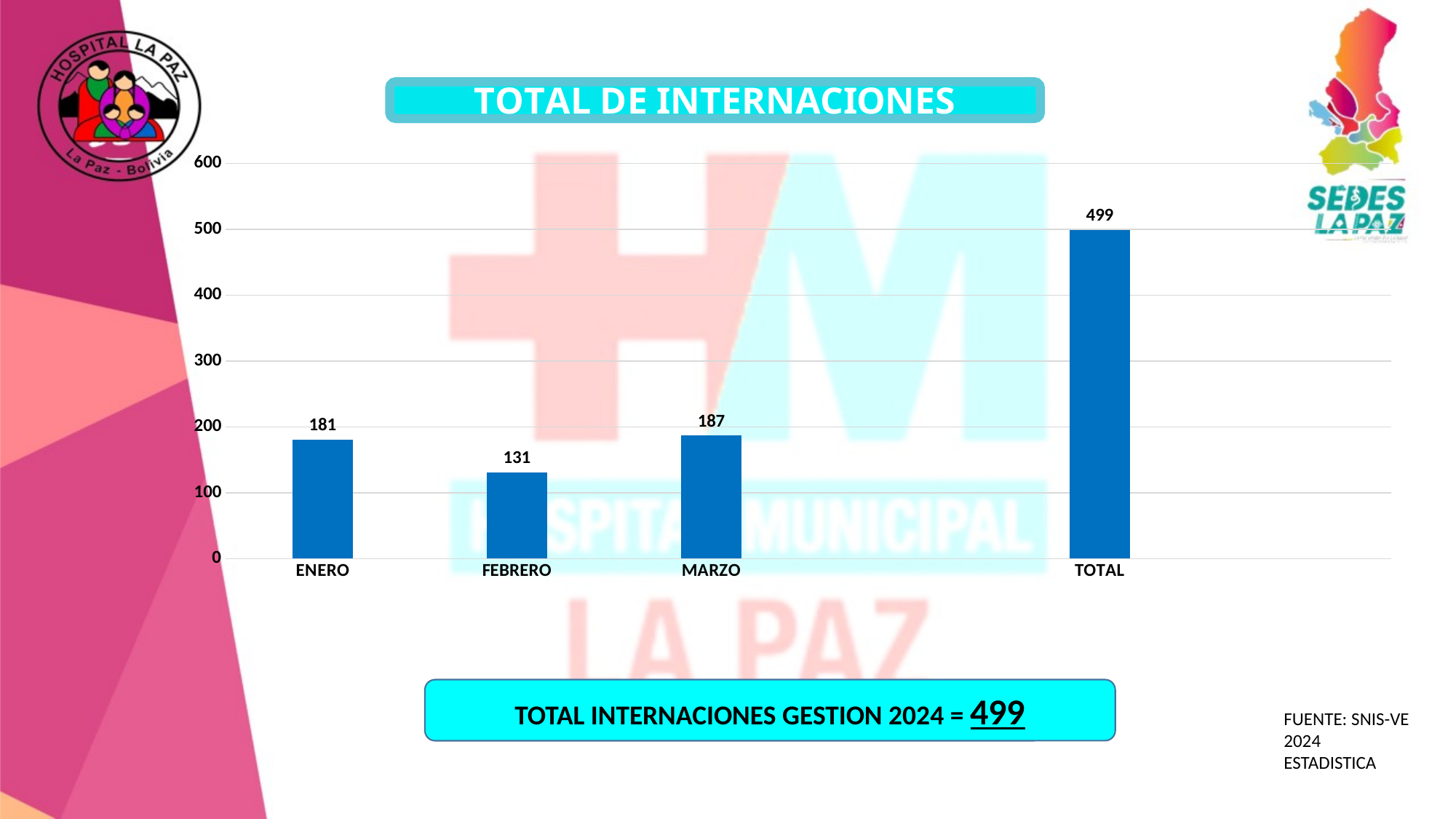
What is the value for TOTAL? 499 What is the value for FEBRERO? 131 Is the value for TOTAL greater or less than 400? greater What is the value for MARZO? 187 What is the difference between the values for MARZO and FEBRERO? 56 Which is larger, the value for ENERO or the value for FEBRERO? ENERO What type of chart is shown on the slide? Bar chart Which month (ENERO, FEBRERO or MARZO) has the lowest value? FEBRERO What is the value for ENERO? 181 Which month (ENERO, FEBRERO or MARZO) has the highest value? MARZO How many bars are shown in the chart? 4 What is the difference between the values for ENERO and FEBRERO? 50